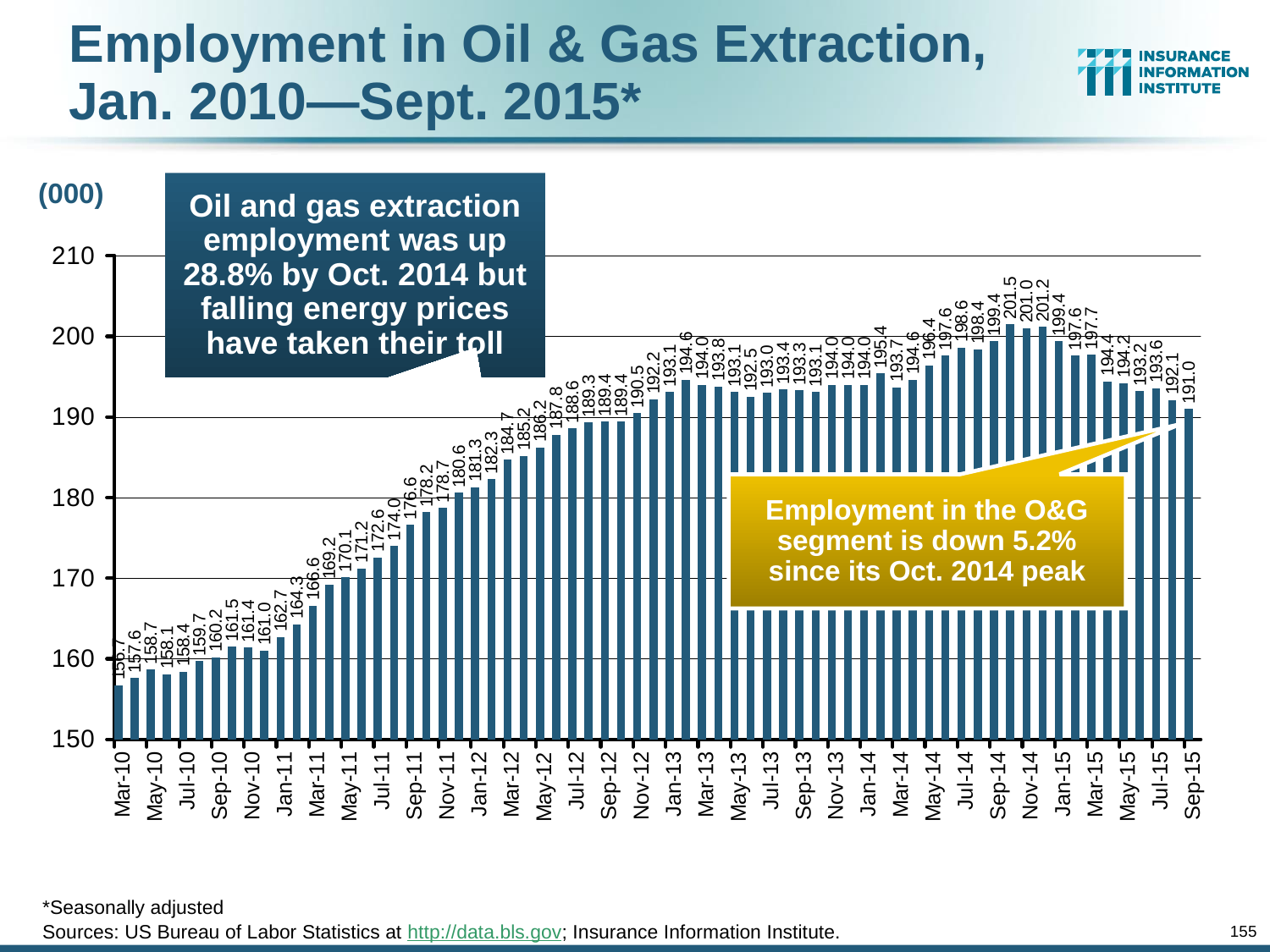
What is the value for Mar-10? 156.7 Which is larger, the value for Jan-13 or the value for Jan-15? Jan-15 What is the value for Mar-15? 197.7 What is the difference between the values for Sep-15 and Mar-10? 34.3 What kind of chart is shown on the slide? Bar chart Which month has the lowest value on the chart? Mar-10 Do the values generally rise or fall from Mar-10 to Sep-14? Rise What is the value for Sep-15? 191.0 What is the value for Sep-14? 199.4 What is the highest value shown on the chart? 201.5 According to the callout, by what percentage is employment in the O&G segment down since its Oct. 2014 peak? 5.2% What is the value for Jan-11? 162.7